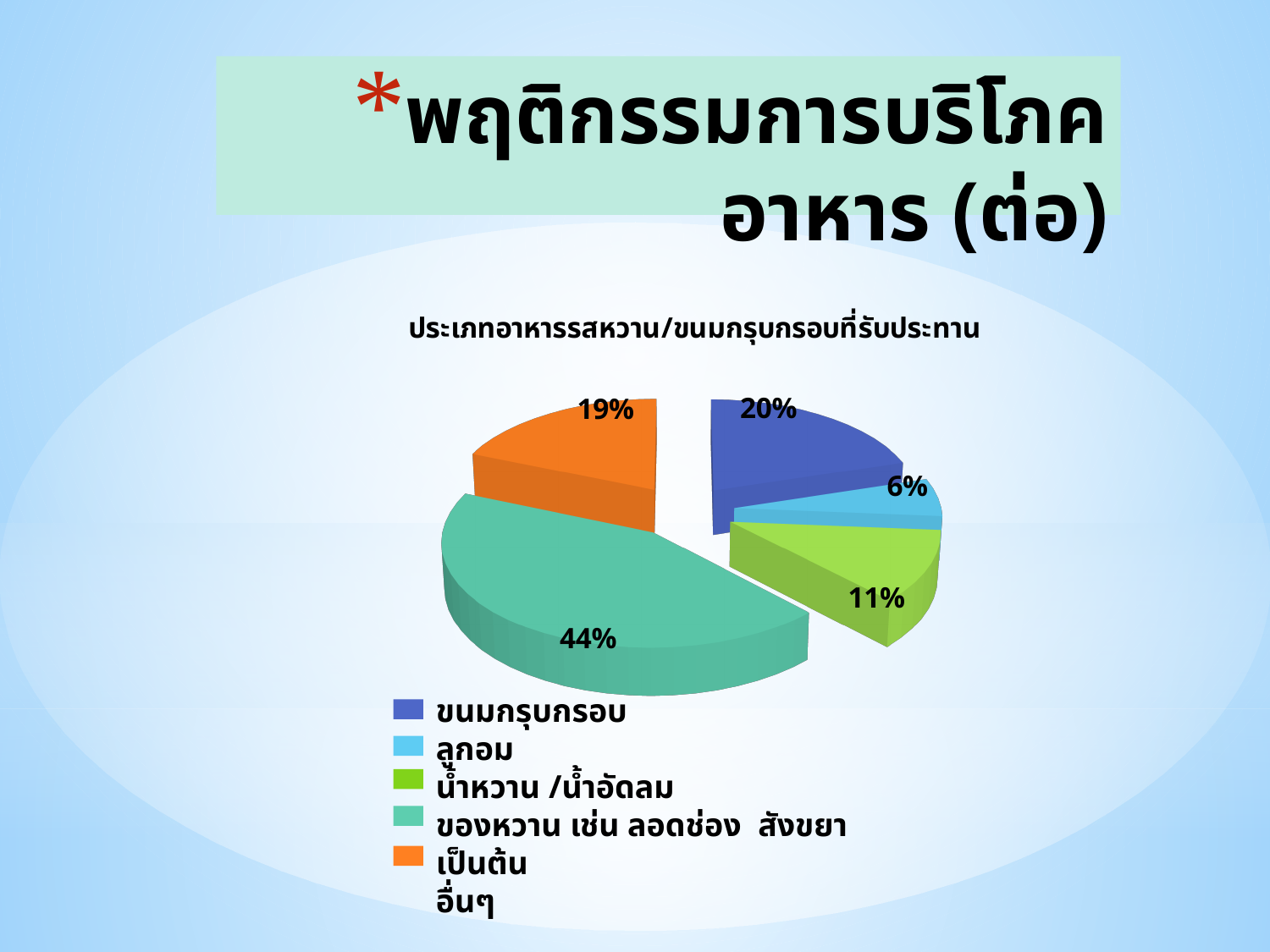
What percentage of the pie is อื่นๆ? 19% Which category has the smallest share of the pie? ลูกอม What is the difference in percentage points between ขนมกรุบกรอบ and อื่นๆ? 1% What percentage of the pie is ขนมกรุบกรอบ? 20% What percentage of the pie is ของหวาน เช่น ลอดช่อง สังขยา เป็นต้น? 44% Which is larger, the share for น้ำหวาน /น้ำอัดลม or the share for ลูกอม? น้ำหวาน /น้ำอัดลม What type of chart is shown on the slide? Pie chart What percentage of the pie is น้ำหวาน /น้ำอัดลม? 11% How many slices does the pie chart have? 5 What is the title of the pie chart? ประเภทอาหารรสหวาน/ขนมกรุบกรอบที่รับประทาน What percentage of the pie is ลูกอม? 6% Which category has the largest share of the pie? ของหวาน เช่น ลอดช่อง สังขยา เป็นต้น